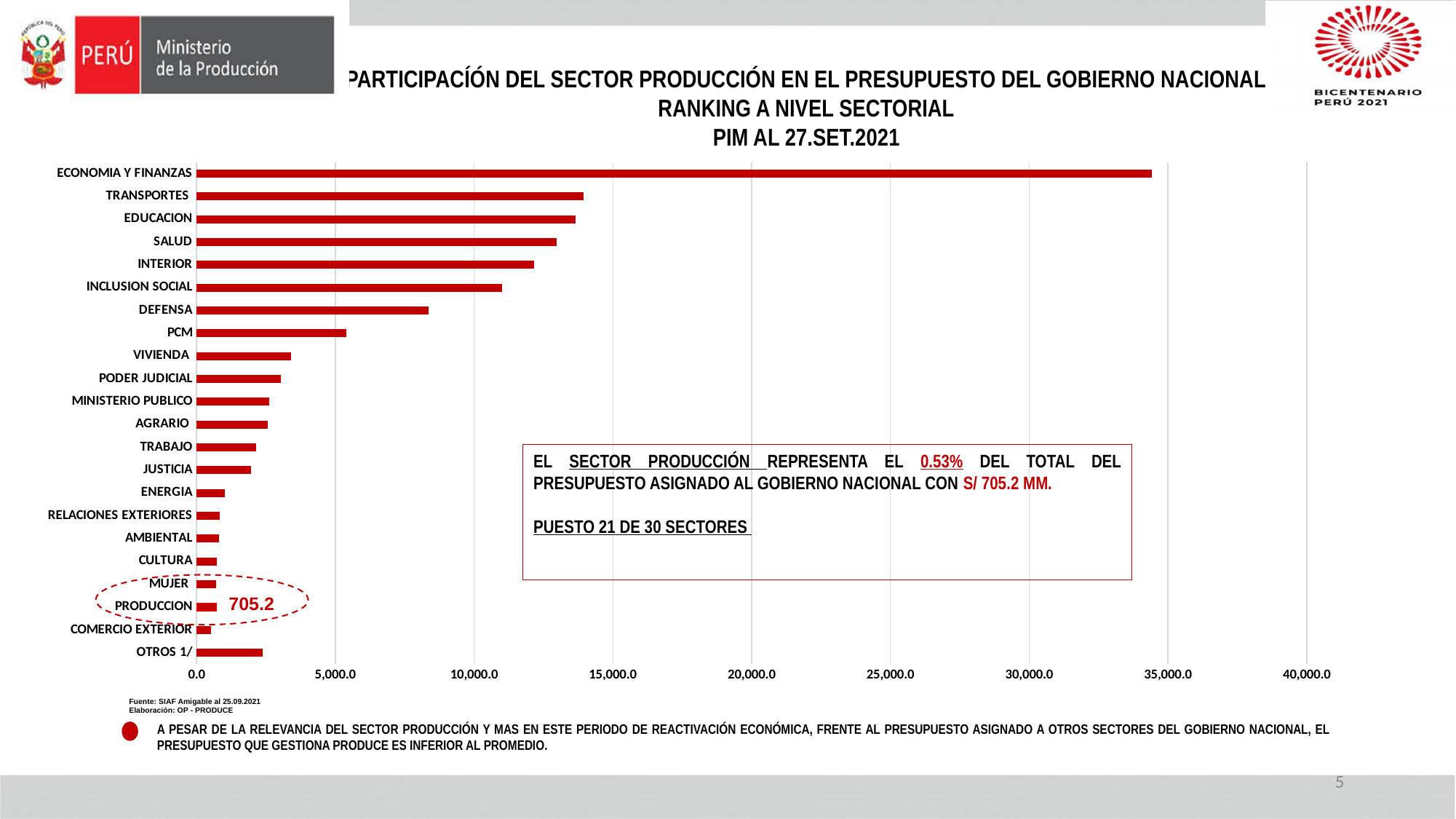
Is the value for DEFENSA greater or less than 10,000.0? less How many sectors (categories) are listed in the chart? 22 Which has a larger value, DEFENSA or PCM? DEFENSA Is the value for INTERIOR greater or less than 10,000.0? greater Is the value for TRANSPORTES greater or less than 15,000.0? less Which sector has the highest value in the chart? ECONOMIA Y FINANZAS Which has a larger value, INCLUSION SOCIAL or VIVIENDA? INCLUSION SOCIAL Which sector's bar is highlighted with a dashed circle on the chart? PRODUCCION What is the value shown for PRODUCCION? 705.2 What kind of chart is shown on the slide? Bar chart Which sector has the lowest value in the chart? COMERCIO EXTERIOR